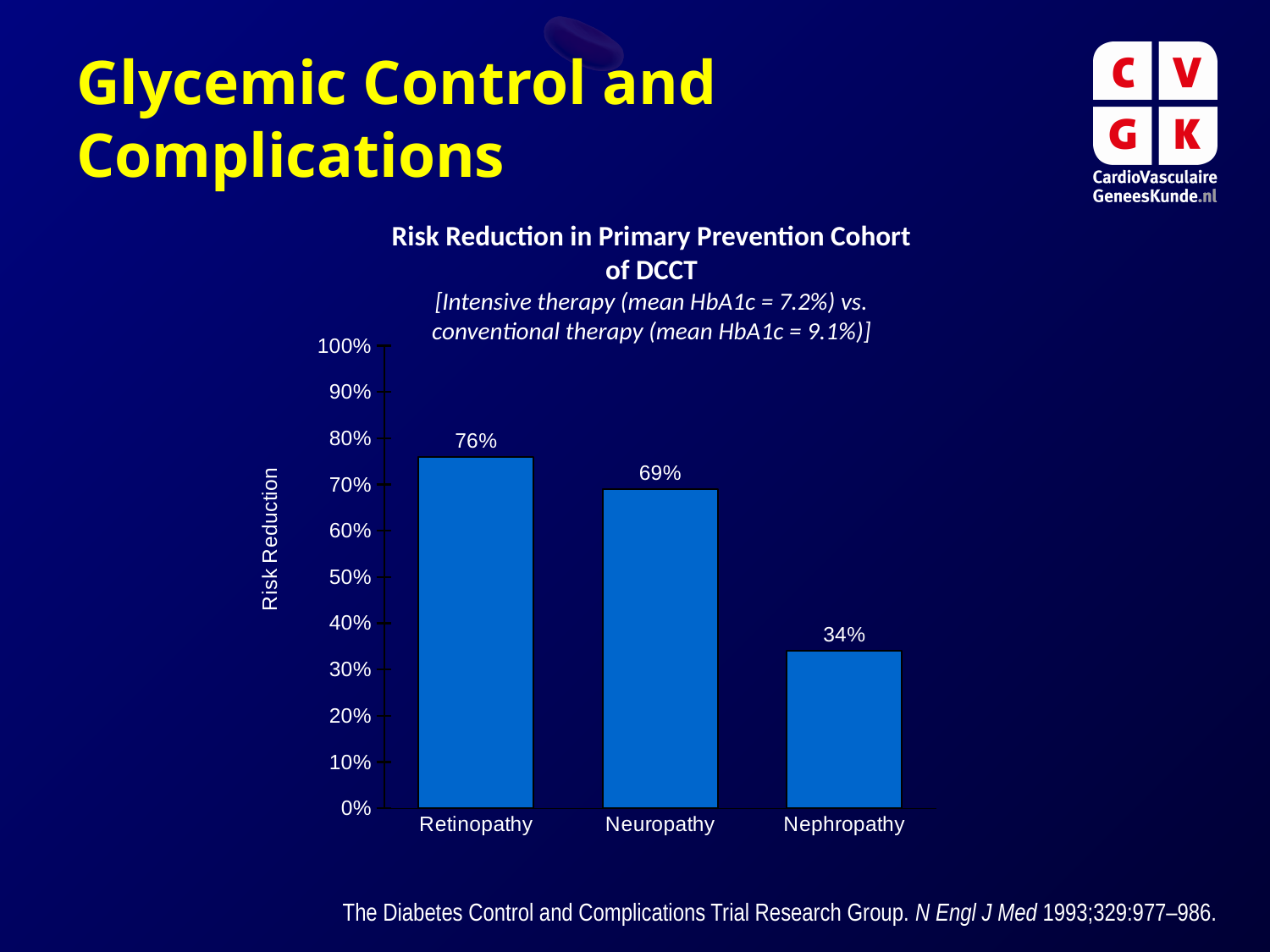
Which complication shows the lowest risk reduction? Nephropathy What is the label on the vertical axis of the chart? Risk Reduction Is the risk reduction for Nephropathy greater or less than 50%? less What is the difference in risk reduction between Retinopathy and Neuropathy? 7% What is the risk reduction for Retinopathy? 76% What is the risk reduction for Nephropathy? 34% What is the difference in risk reduction between Retinopathy and Nephropathy? 42% Which complication shows the highest risk reduction? Retinopathy Which has a larger risk reduction, Neuropathy or Nephropathy? Neuropathy How many complication categories are shown in the chart? 3 What is the risk reduction for Neuropathy? 69% What kind of chart is shown on the slide? Bar chart